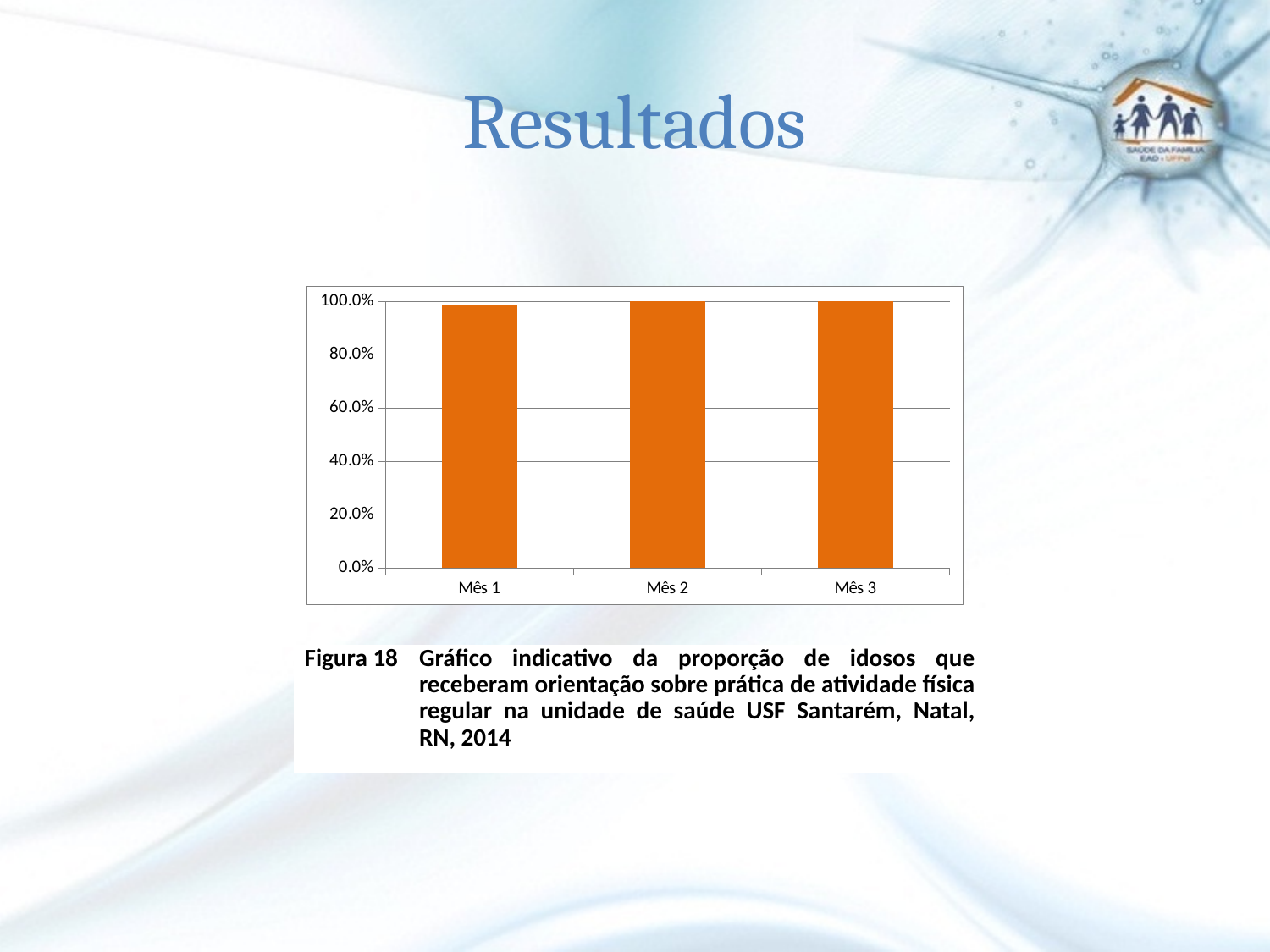
How many categories (months) are shown on the x axis of the chart? 3 Is the value for Mês 1 greater or less than 80.0%? greater What is the value for Mês 2 in the chart? 100.0% What kind of chart is shown on the slide? bar chart Which month has the lowest value in the chart? Mês 1 Is the value for Mês 1 greater or less than 60.0%? greater Which is larger, the value for Mês 1 or the value for Mês 2? Mês 2 What colour are the bars in the chart? orange What is the value for Mês 3 in the chart? 100.0% What is the highest value shown on the y axis of the chart? 100.0%